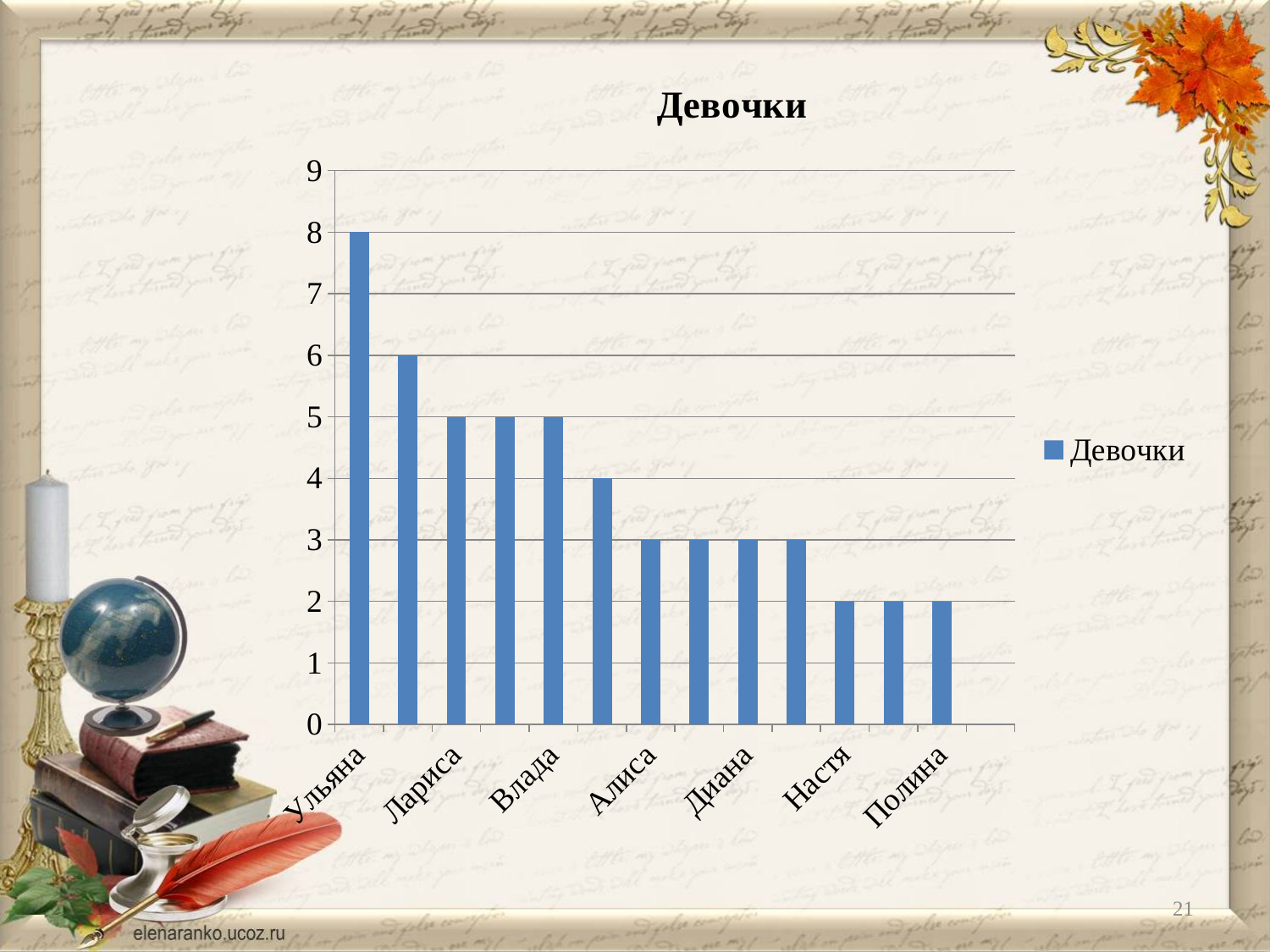
What is the value for Алиса? 3 What is the difference between the values for Ульяна and Лариса? 3 What is the value for Лариса? 5 What is the value for Ульяна? 8 Which is larger, the value for Влада or the value for Настя? Влада How many series does the legend list? 1 What is the title of the chart? Девочки What is the value for Полина? 2 How many bars are plotted in the chart? 13 What kind of chart is shown on the slide? bar chart Do the values generally rise or fall from left to right along the x axis? fall Which category has the highest value? Ульяна